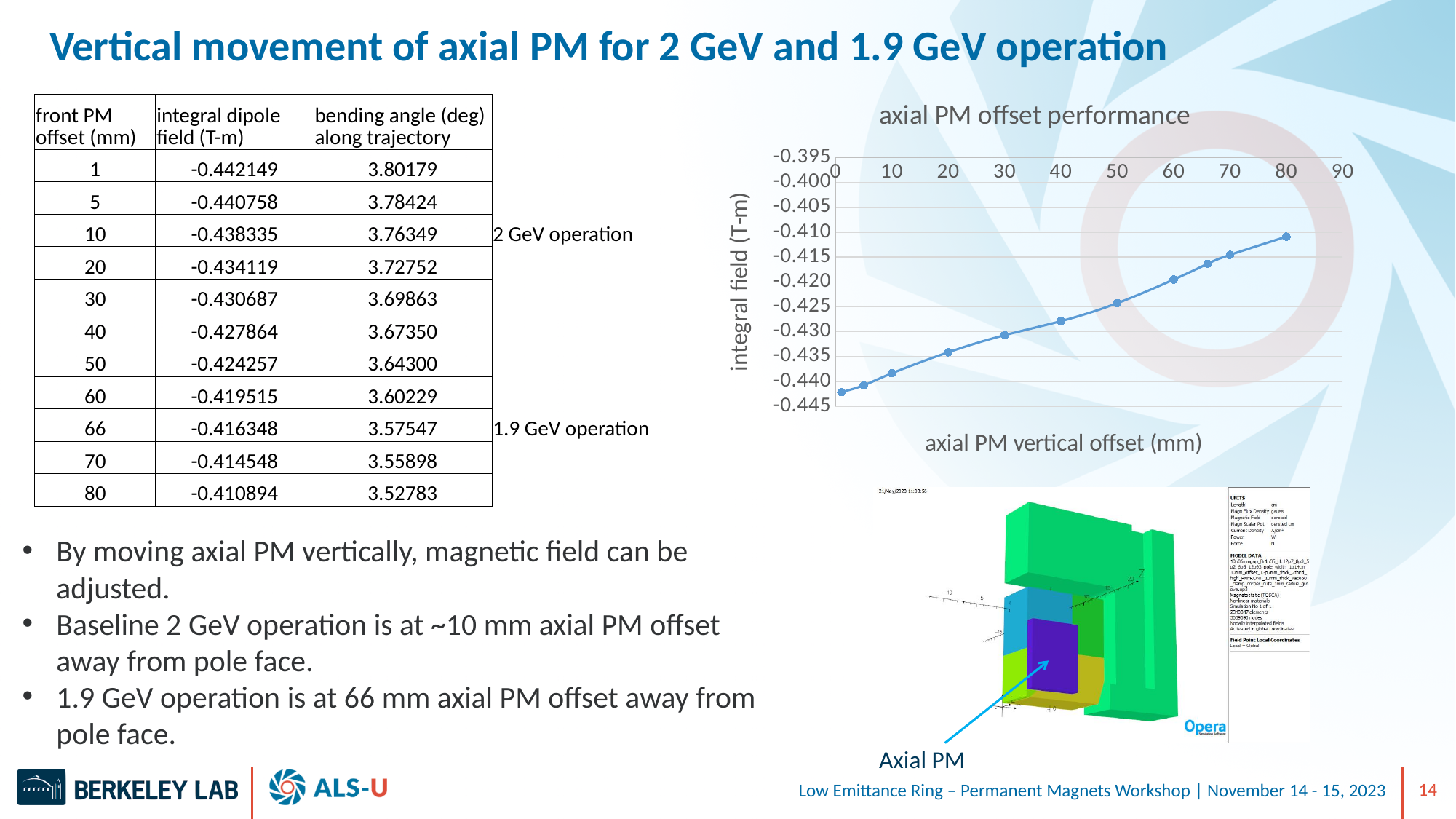
According to the table on the slide, what is the integral dipole field plotted at 80 mm front PM offset? -0.410894 What is the y-axis label of the 'axial PM offset performance' chart? integral field (T-m) What is the title of the chart on the slide? axial PM offset performance On the 'axial PM offset performance' chart, is the integral field at 40 mm offset greater or less than -0.430? greater On the 'axial PM offset performance' chart, at which axial PM vertical offset is the integral field highest? 80 mm On the 'axial PM offset performance' chart, is the integral field at 1 mm offset greater or less than -0.440? less On the 'axial PM offset performance' chart, which has the larger integral field: the point at 20 mm offset or the point at 70 mm offset? 70 mm On the 'axial PM offset performance' chart, is the integral field at 80 mm offset greater or less than -0.415? greater How many data points are plotted on the 'axial PM offset performance' chart? 11 On the 'axial PM offset performance' chart, at which axial PM vertical offset is the integral field lowest? 1 mm What kind of chart is the 'axial PM offset performance' chart? line chart On the 'axial PM offset performance' chart, does the integral field rise or fall as the axial PM vertical offset increases? rise